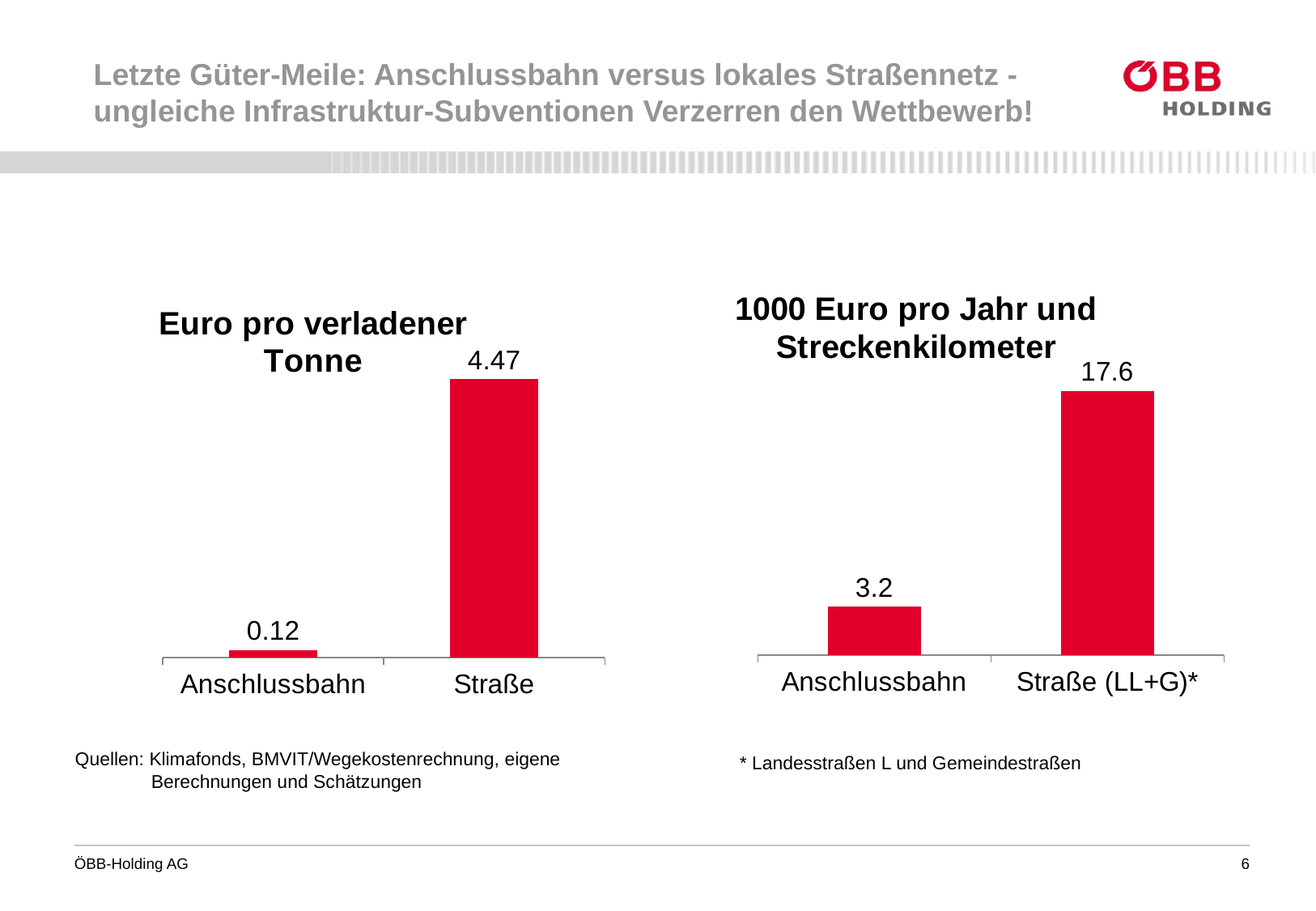
In the chart titled "Euro pro verladener Tonne", what is the value for Anschlussbahn? 0.12 In the chart titled "1000 Euro pro Jahr und Streckenkilometer", which category has the lowest value? Anschlussbahn In the chart titled "1000 Euro pro Jahr und Streckenkilometer", what is the difference between the values for Straße (LL+G)* and Anschlussbahn? 14.4 In the chart titled "Euro pro verladener Tonne", which category has the highest value? Straße In the chart titled "1000 Euro pro Jahr und Streckenkilometer", which is larger, the value for Anschlussbahn or the value for Straße (LL+G)*? Straße (LL+G)* How many categories are shown in the chart titled "Euro pro verladener Tonne"? 2 In the chart titled "1000 Euro pro Jahr und Streckenkilometer", what is the value for Anschlussbahn? 3.2 What kind of chart is the chart on the right of the slide? Bar chart In the chart titled "Euro pro verladener Tonne", what is the value for Straße? 4.47 What is the title of the chart on the left of the slide? Euro pro verladener Tonne In the chart titled "Euro pro verladener Tonne", what is the difference between the values for Straße and Anschlussbahn? 4.35 In the chart titled "1000 Euro pro Jahr und Streckenkilometer", what is the value for Straße (LL+G)*? 17.6